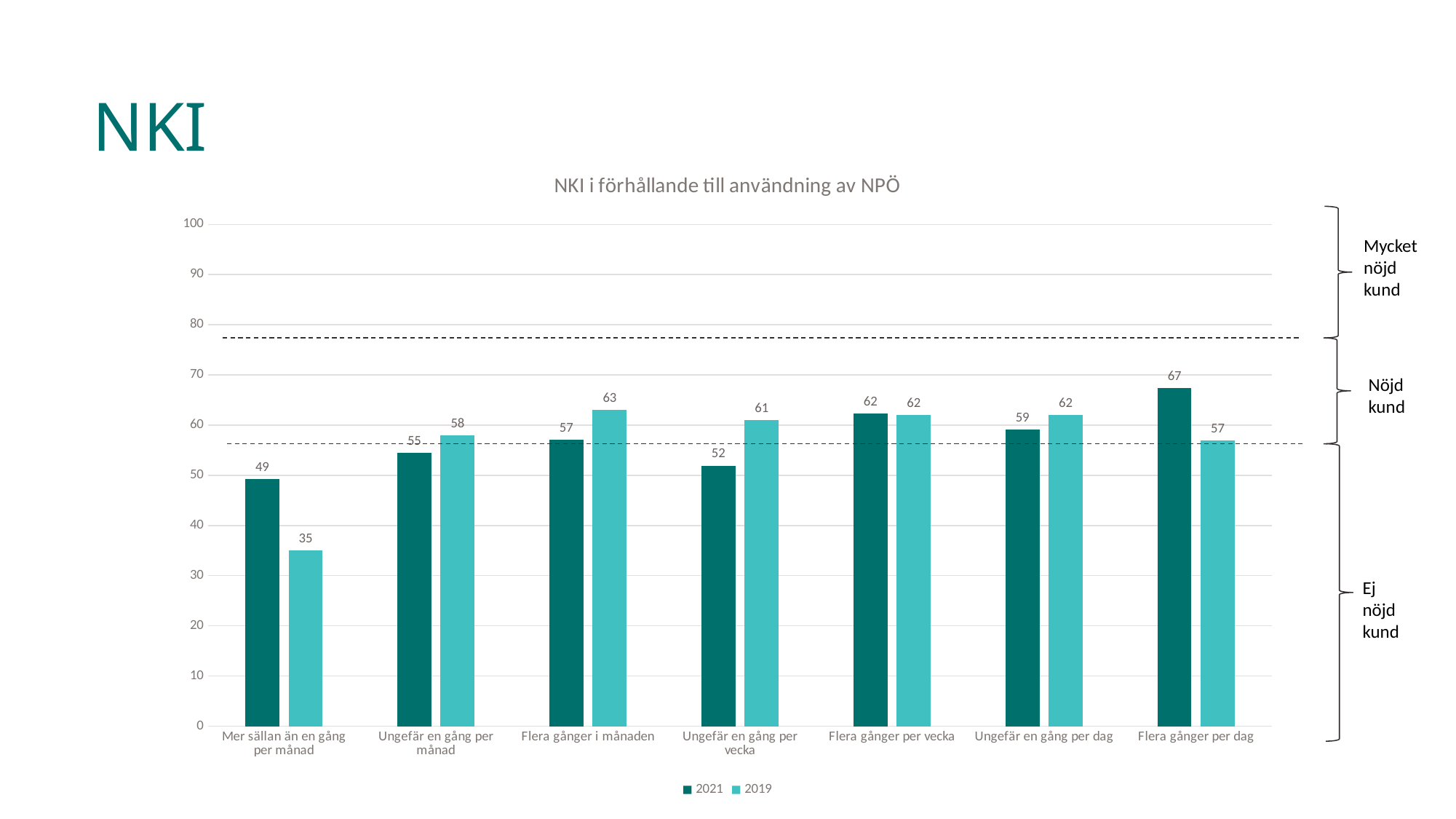
What type of chart is shown? bar chart What is the 2021 value for "Flera gånger per dag"? 67 What is the 2019 value for "Flera gånger i månaden"? 63 What is the difference between the 2019 and 2021 values for "Ungefär en gång per vecka"? 9 Which category has the highest 2021 value? Flera gånger per dag How many categories are shown on the x axis? 7 How many series does the legend list? 2 Which category has the lowest 2019 value? Mer sällan än en gång per månad Is the 2021 value for "Ungefär en gång per månad" greater or less than 60? less What is the 2019 value for "Mer sällan än en gång per månad"? 35 Which is larger for "Flera gånger per dag": the 2021 value or the 2019 value? 2021 What is the difference between the 2021 and 2019 values for "Mer sällan än en gång per månad"? 14